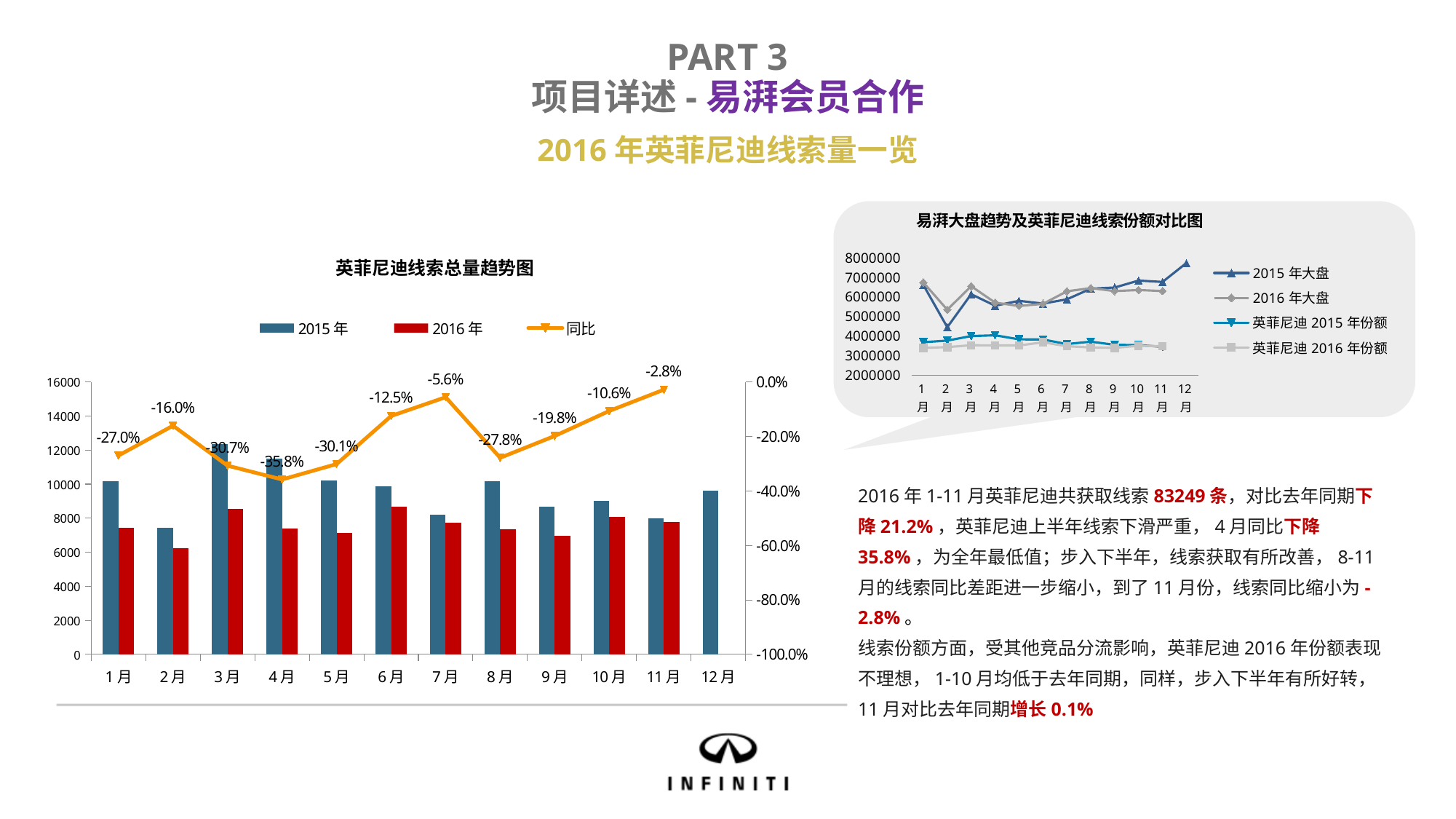
What kind of chart is the 易湃大盘趋势及英菲尼迪线索份额对比图 chart? line chart In the 英菲尼迪线索总量趋势图 chart, what is the difference between the 同比 values for 7月 and 4月? 30.2 percentage points In the 英菲尼迪线索总量趋势图 chart, what is the 同比 value for 4月? -35.8% In the 英菲尼迪线索总量趋势图 chart, which month has the highest 同比 value? 11月 How many series does the legend of the 英菲尼迪线索总量趋势图 chart list? 3 In the 英菲尼迪线索总量趋势图 chart, is the 2016年 value for 6月 greater or less than 8000? greater How many months are shown on the x axis of the 英菲尼迪线索总量趋势图 chart? 12 In the 英菲尼迪线索总量趋势图 chart, what is the 同比 value for 11月? -2.8% In the 英菲尼迪线索总量趋势图 chart, is the 2015年 value for 2月 greater or less than 8000? less How many series does the legend of the 易湃大盘趋势及英菲尼迪线索份额对比图 chart list? 4 In the 英菲尼迪线索总量趋势图 chart, which month has the lowest 同比 value? 4月 In the 英菲尼迪线索总量趋势图 chart, which is larger for 1月: the 2015年 bar or the 2016年 bar? 2015年